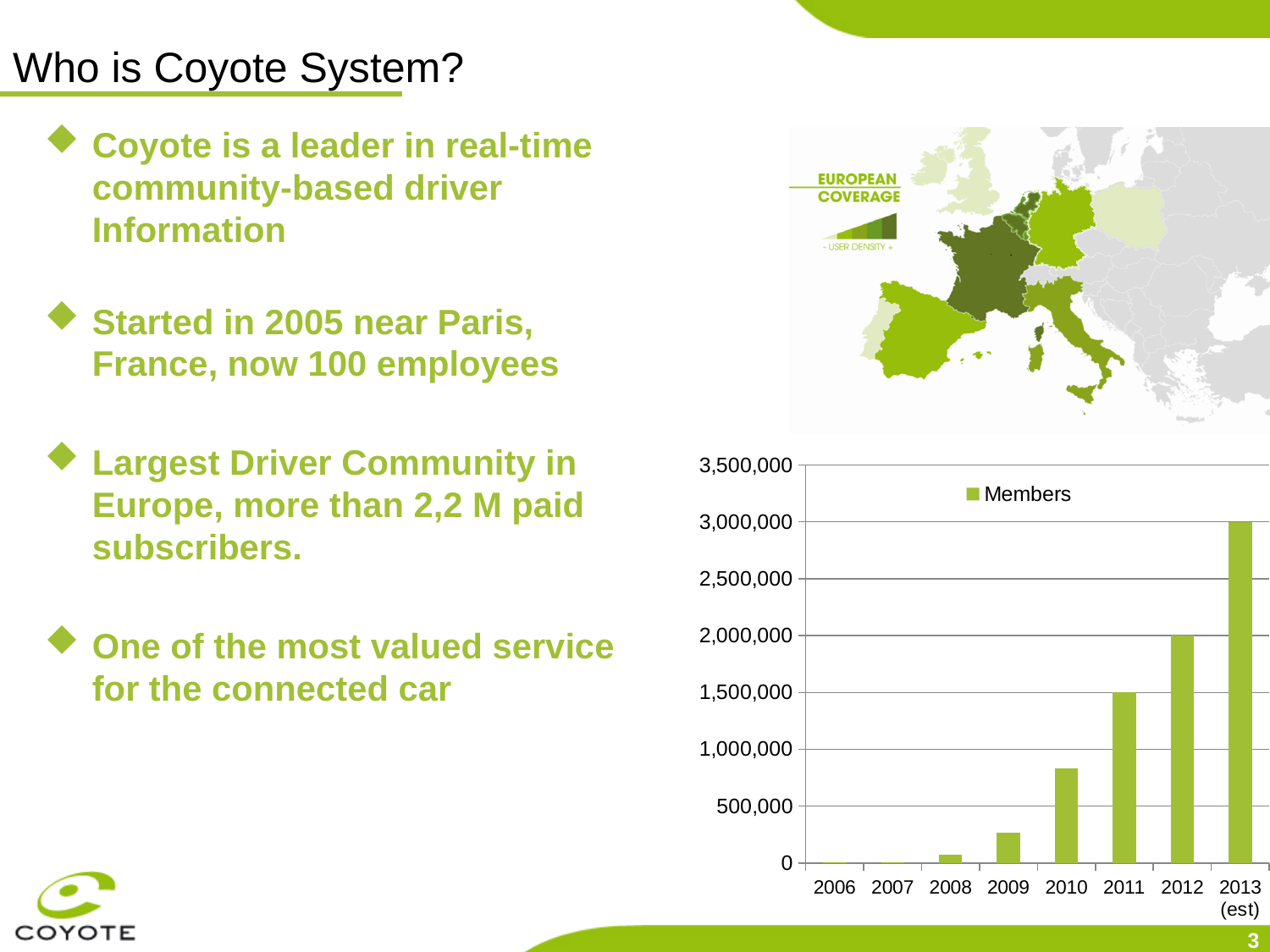
What kind of chart is shown on the slide? bar chart Is the value for Members in 2009 greater or less than 500,000? less Which year has the highest number of Members? 2013 (est) What is the name of the series shown in the chart legend? Members What is the value for Members in 2013 (est)? 3,000,000 How many series does the chart legend list? 1 Do the Members values rise or fall from 2006 to 2013 (est)? rise How many years (categories) are shown on the x axis of the chart? 8 What is the value for Members in 2011? 1,500,000 Is the value for Members in 2010 greater or less than 1,000,000? less What is the value for Members in 2012? 2,000,000 What is the difference in Members between 2013 (est) and 2012? 1,000,000